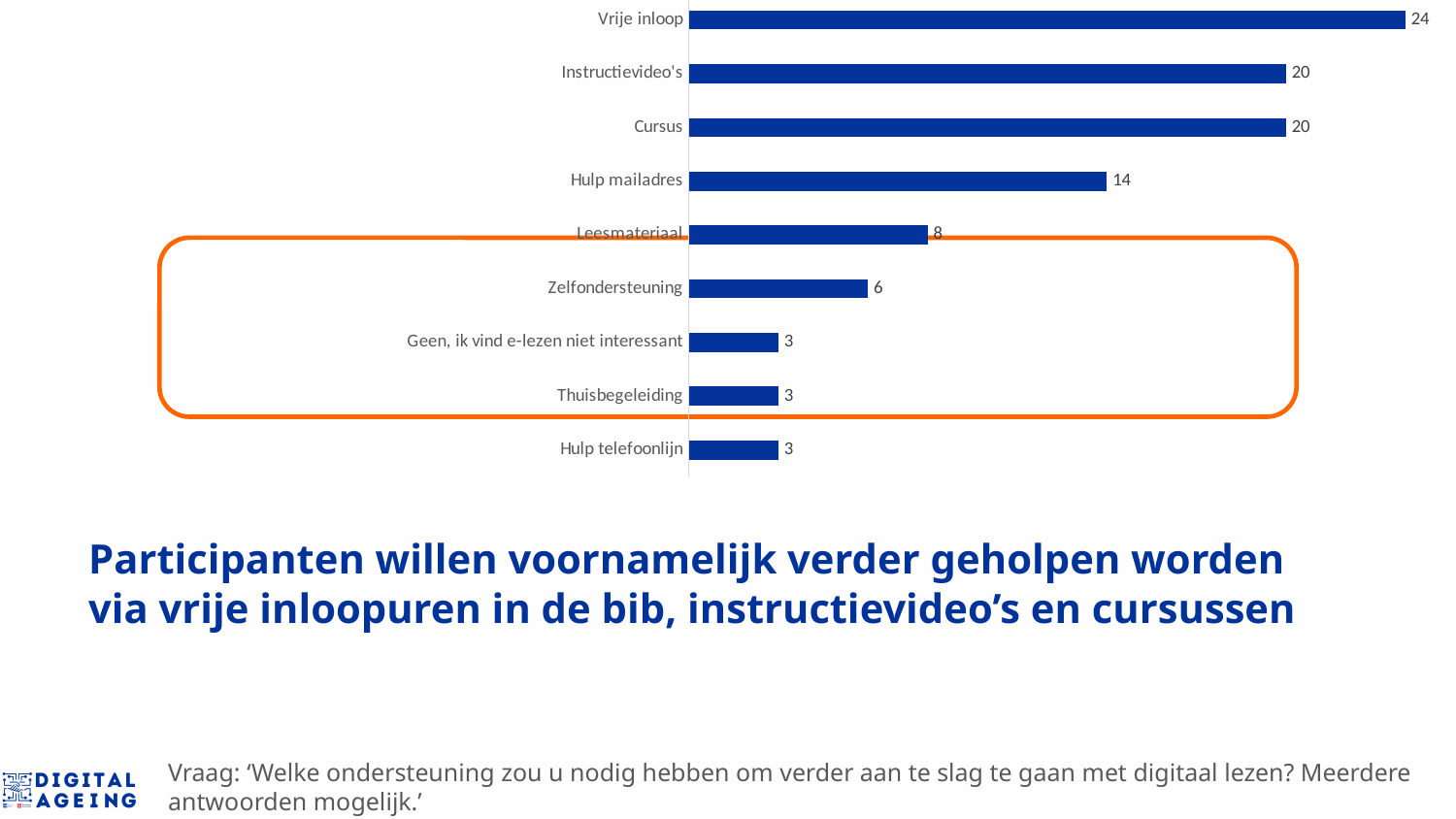
What value is shown for Leesmateriaal? 8 How many categories are shown in the chart? 9 What value is shown for Zelfondersteuning? 6 What is the difference between the values for Hulp mailadres and Leesmateriaal? 6 Do the values rise or fall going from the top category to the bottom category? Fall What colour are the bars in the chart? Blue Which category has the highest value? Vrije inloop What is the difference between the values for Vrije inloop and Cursus? 4 What value is shown for Vrije inloop? 24 What value is shown for Hulp mailadres? 14 What kind of chart is shown on the slide? Bar chart Which has a larger value, Instructievideo's or Hulp mailadres? Instructievideo's